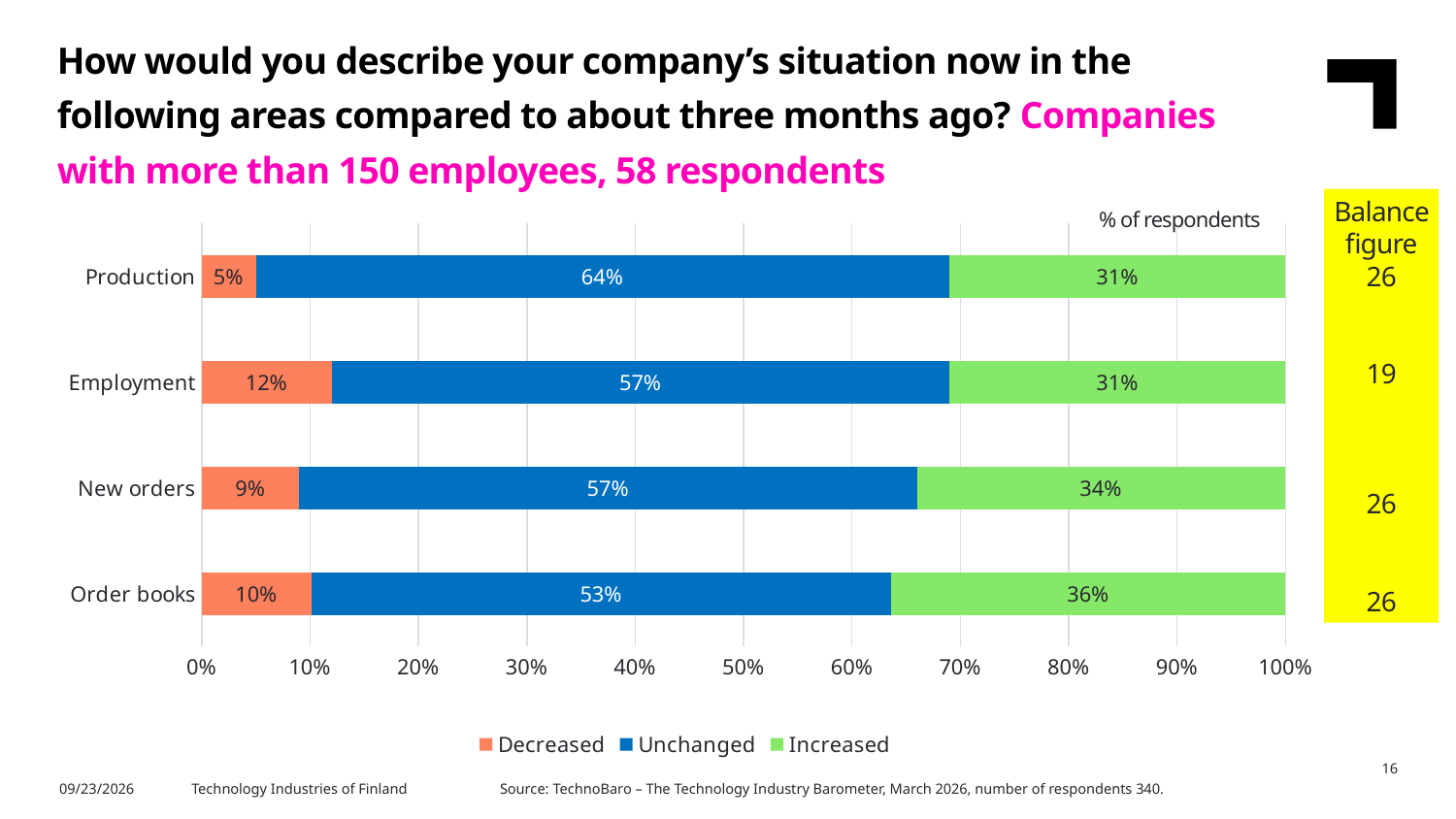
What percentage of respondents reported that Order books increased? 36% What kind of chart is shown on the slide? Stacked bar chart What percentage of respondents reported that Employment decreased? 12% How many series does the legend list? 3 Which is larger: the 'Decreased' share for Employment or the 'Decreased' share for New orders? Employment Which category has the lowest share of respondents reporting 'Decreased'? Production Which colour represents the 'Unchanged' series in the legend? Blue How many categories are shown on the chart? 4 Which category has the highest share of respondents reporting 'Increased'? Order books What is the difference between the 'Increased' share for Order books and the 'Increased' share for Production? 5% What percentage of respondents reported that Production was unchanged? 64% What is the balance figure shown for Employment? 19